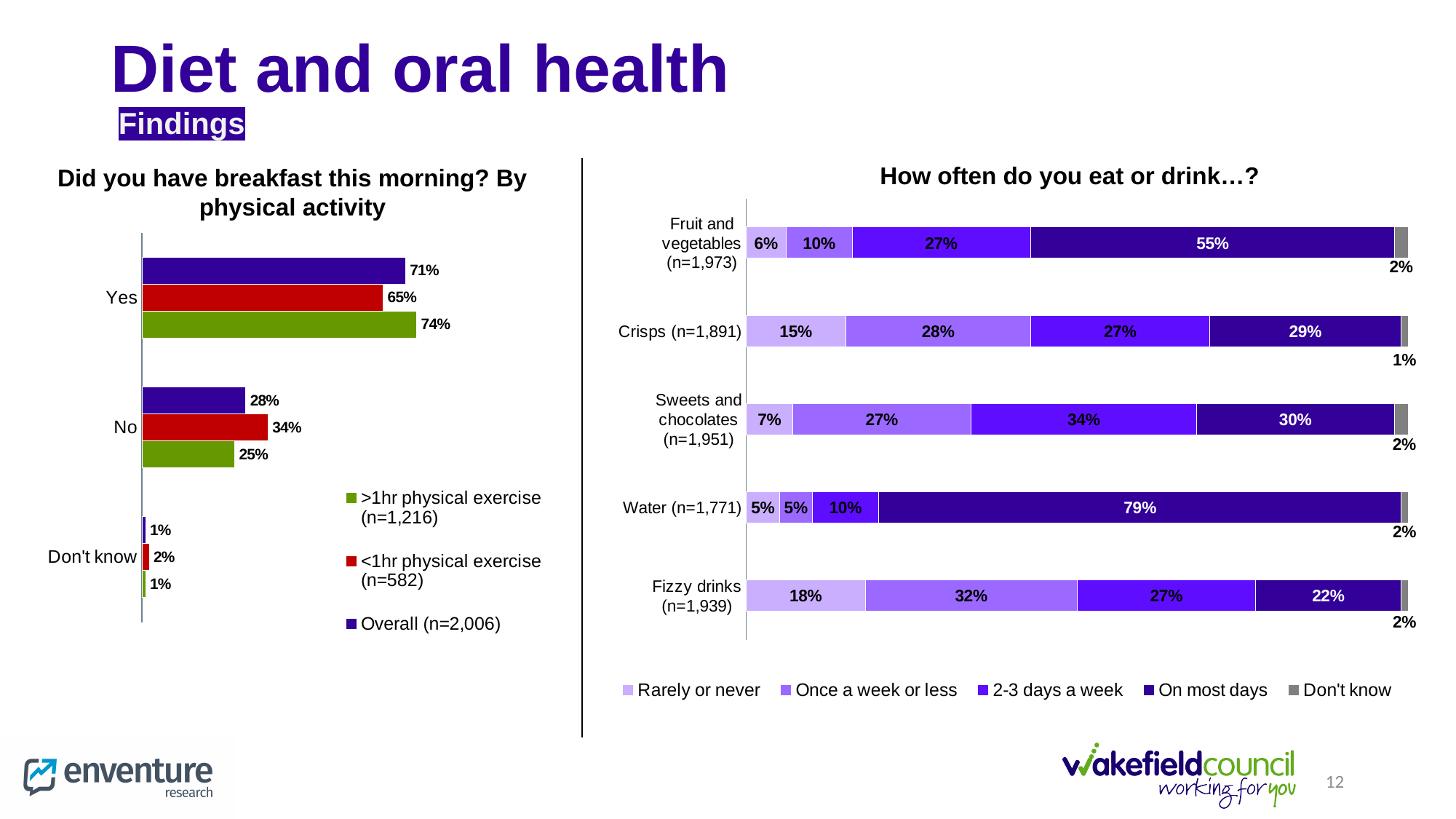
In the 'How often do you eat or drink…?' chart, what percentage of respondents eat Crisps once a week or less? 28% In the 'How often do you eat or drink…?' chart, how many food or drink categories are shown? 5 In the 'Did you have breakfast this morning? By physical activity' chart, what percentage of the Overall (n=2,006) group answered Yes? 71% In the 'How often do you eat or drink…?' chart, what percentage of respondents drink Water on most days? 79% In the 'Did you have breakfast this morning? By physical activity' chart, what is the difference between the >1hr physical exercise and <1hr physical exercise groups for Yes? 9 percentage points In the 'How often do you eat or drink…?' chart, which is larger: the 'On most days' value for Fruit and vegetables or for Sweets and chocolates? Fruit and vegetables What type of chart is 'Did you have breakfast this morning? By physical activity'? Bar chart In the 'Did you have breakfast this morning? By physical activity' chart, which group has the highest percentage answering Yes? >1hr physical exercise (n=1,216) In the 'Did you have breakfast this morning? By physical activity' chart, how many series does the legend list? 3 In the 'How often do you eat or drink…?' chart, which item has the highest 'Rarely or never' percentage? Fizzy drinks (n=1,939) In the 'How often do you eat or drink…?' chart, what is the total of the Fizzy drinks bar? 101% In the 'Did you have breakfast this morning? By physical activity' chart, what percentage of the <1hr physical exercise (n=582) group answered No? 34%